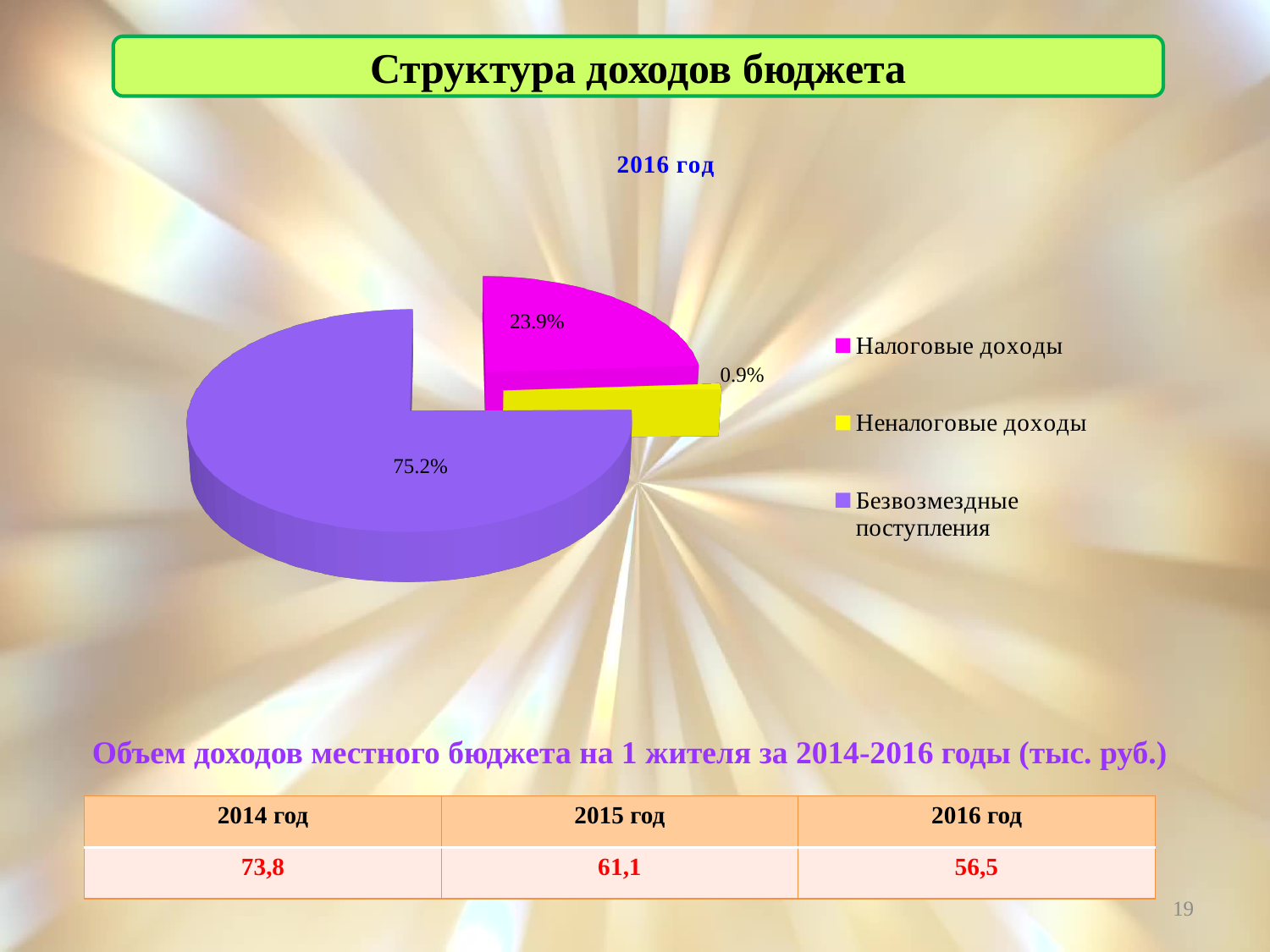
How many slices does the pie chart have? 3 What is the difference in percentage points between Безвозмездные поступления and Налоговые доходы? 51.3 What kind of chart is shown on the slide? Pie chart What share of the pie does Неналоговые доходы have? 0.9% Which is larger, the slice for Налоговые доходы or the slice for Неналоговые доходы? Налоговые доходы Which category has the largest slice of the pie? Безвозмездные поступления Which year does the pie chart show? 2016 год How many entries does the legend list? 3 Which category has the smallest slice of the pie? Неналоговые доходы What share of the pie does Налоговые доходы have? 23.9% What colour is the slice for Безвозмездные поступления? Purple What share of the pie does Безвозмездные поступления have? 75.2%